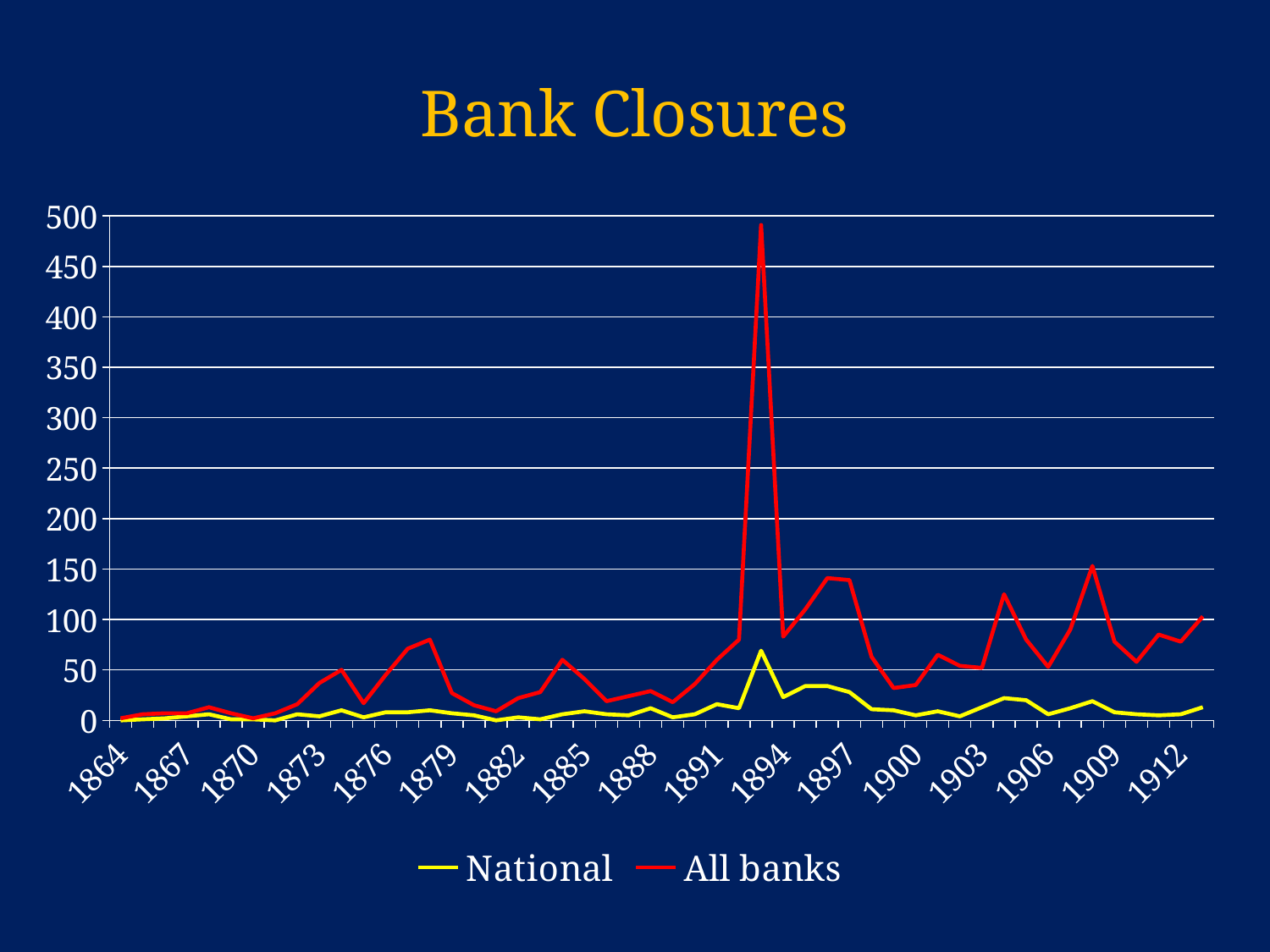
How many year labels are shown on the x axis? 17 Is the peak value of the National series greater or less than 50? greater Is the value for All banks in 1900 greater or less than 50? less Between which two labeled years does the All banks series reach its highest peak? 1891 and 1894 What kind of chart is shown on the slide? line chart What is the title of the chart? Bank Closures What are the two series named in the legend? National and All banks How many series does the legend list? 2 Is the peak value of the All banks series greater or less than 450? greater Which series is higher in 1897, National or All banks? All banks